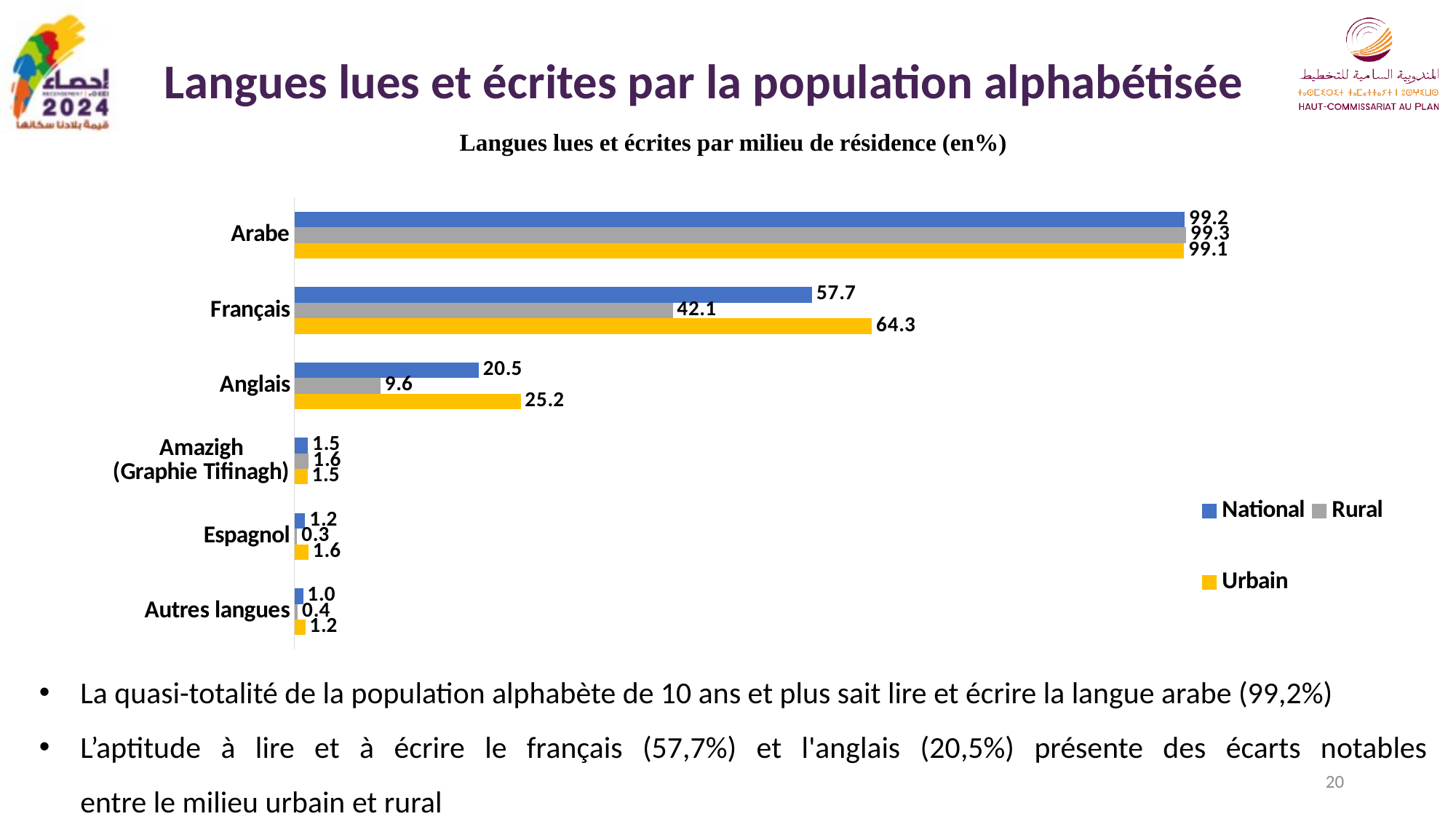
Which language has the lowest Rural value? Espagnol What kind of chart is shown on the slide? Bar chart What is the Urbain value for Espagnol? 1.6 What is the difference between the Urbain and Rural values for Français? 22.2 Which colour represents the Rural series in the chart? Grey How many series does the legend list? 3 What is the Rural value for Anglais? 9.6 How many languages (categories) are shown on the chart? 6 What is the title of the chart? Langues lues et écrites par milieu de résidence (en%) What is the National value for Français? 57.7 Which is larger for Anglais: the National value or the Urbain value? Urbain Which language has the highest Urbain value? Arabe